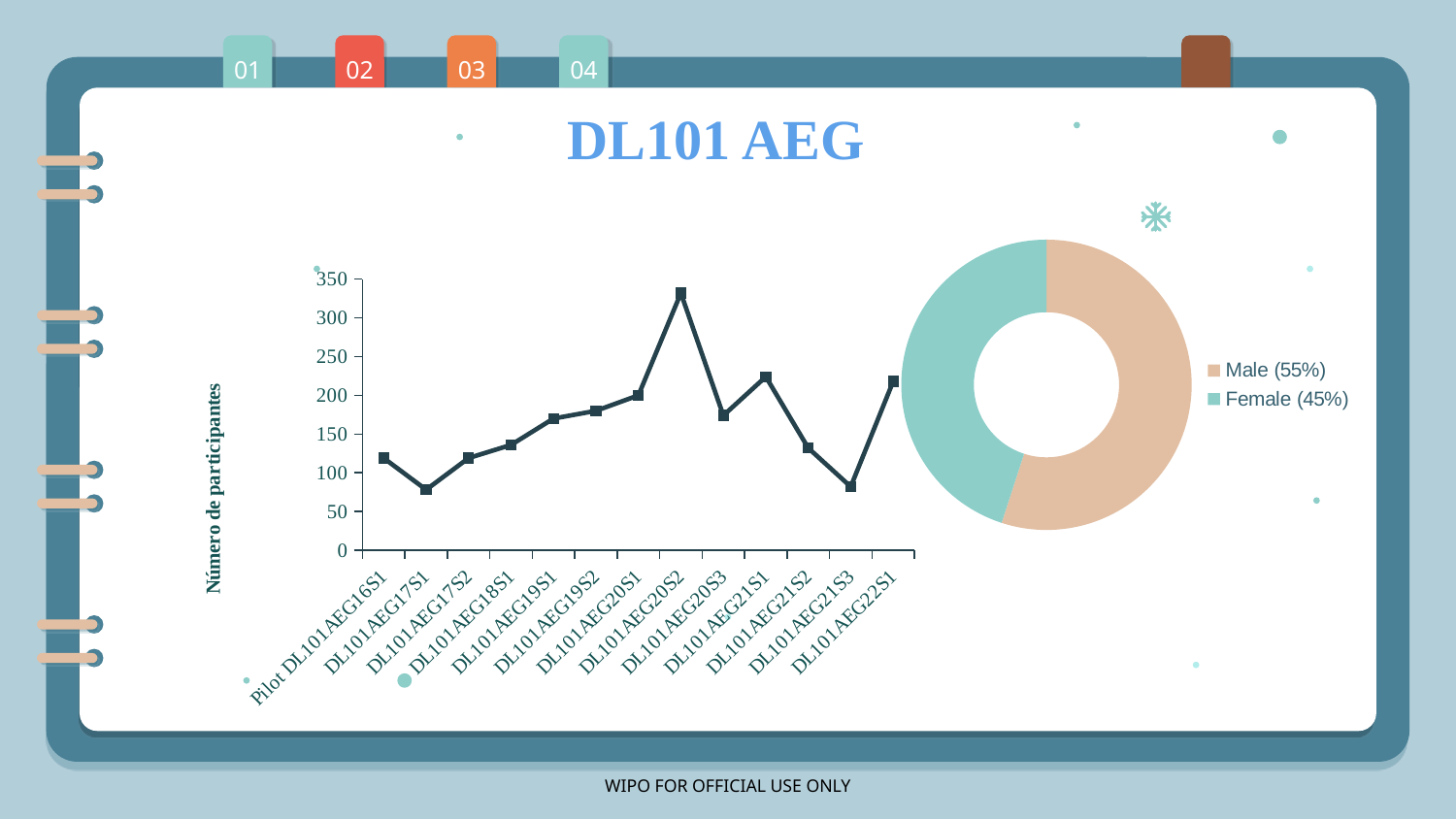
In the line chart on the left, is the value for DL101AEG19S1 greater or less than 150? greater In the line chart on the left, is the value for DL101AEG20S2 greater or less than 300? greater In the line chart on the left, which category has the highest number of participants? DL101AEG20S2 What type of chart is the chart on the right of the slide? doughnut chart In the pie chart on the right, what share of participants is Female? 45% In the line chart on the left, is the value for DL101AEG17S1 greater or less than 100? less In the line chart on the left, how many categories are shown on the x axis? 13 In the line chart on the left, which is larger, the value for DL101AEG20S2 or DL101AEG20S3? DL101AEG20S2 What type of chart is the chart on the left of the slide? line chart In the line chart on the left, which is larger, the value for DL101AEG21S1 or DL101AEG21S2? DL101AEG21S1 What is the y-axis title of the line chart on the left? Número de participantes In the pie chart on the right, what share of participants is Male? 55%